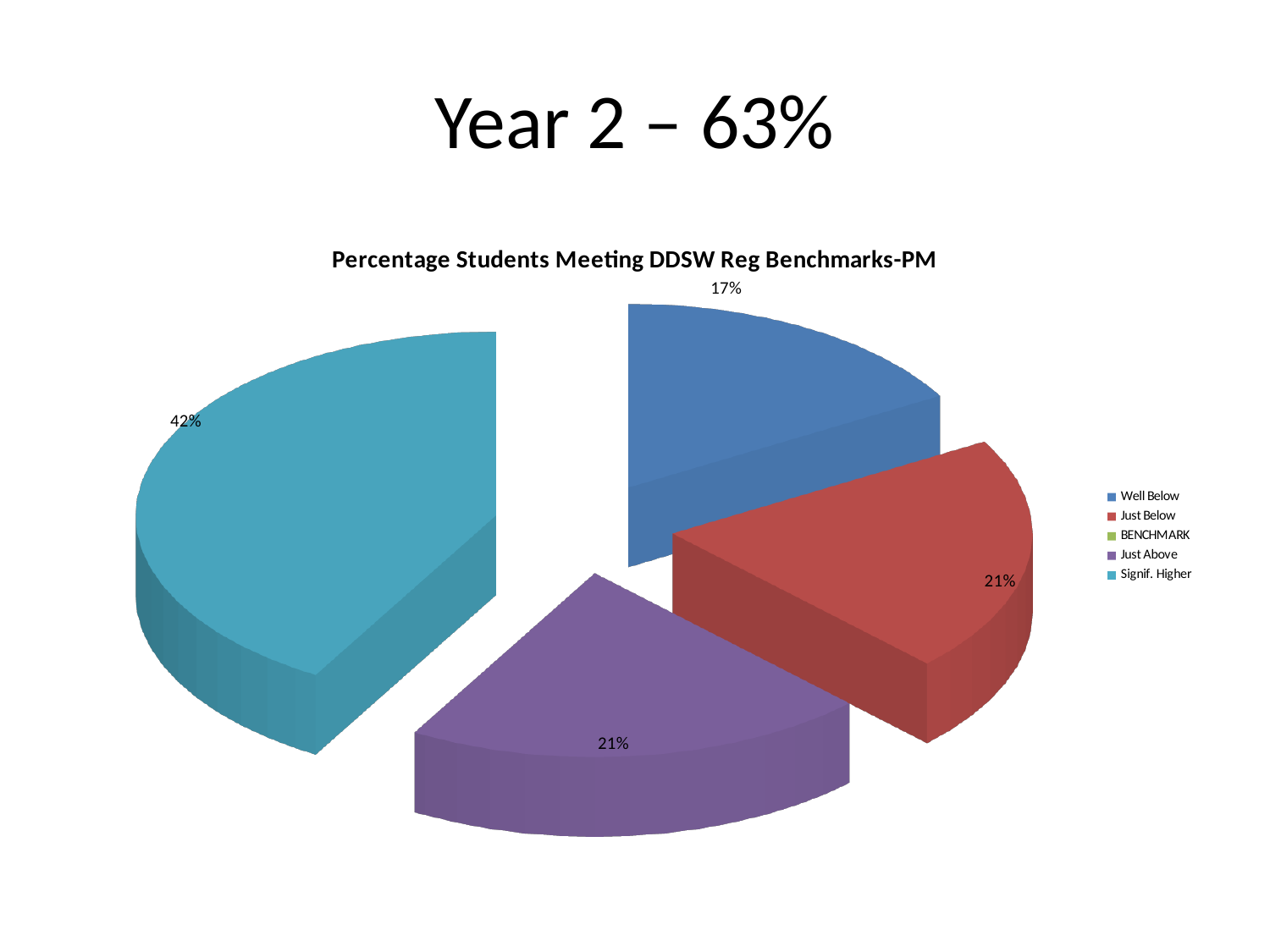
What is the title of the chart? Percentage Students Meeting DDSW Reg Benchmarks-PM What is the difference in percentage points between the Signif. Higher slice and the Well Below slice? 25 percentage points Which category has the largest slice of the pie? Signif. Higher What percentage of students are in the Well Below category? 17% What colour represents the Signif. Higher category in the legend? Teal (light blue) What percentage of students are in the Signif. Higher category? 42% What percentage of students are in the Just Below category? 21% How many categories are listed in the chart's legend? 5 What type of chart is shown on the slide? Pie chart Among the slices drawn on the pie, which category has the smallest slice? Well Below Which is larger, the Signif. Higher slice or the Just Below slice? Signif. Higher What percentage of students are in the Just Above category? 21%